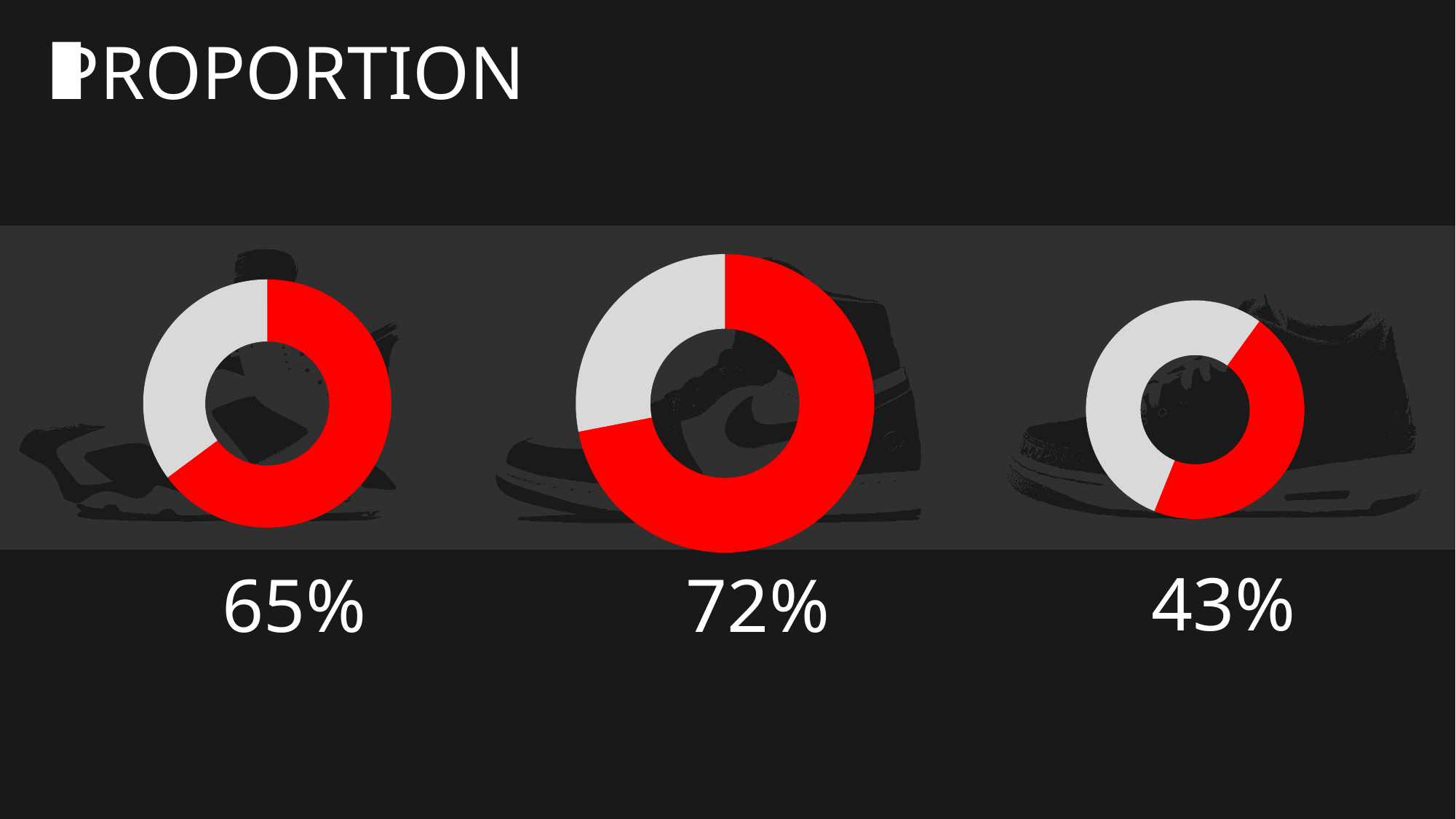
What percentage is shown below the left doughnut chart? 65% What is the title of the slide? PROPORTION What is the difference between the percentage of the middle chart and the percentage of the left chart? 7% How many doughnut charts are shown on the slide? 3 What colour is used for the filled (percentage) portion of each doughnut chart? Red Which of the three doughnut charts shows the lowest percentage? The right chart (43%) What percentage is shown below the right doughnut chart? 43% What percentage is shown below the middle doughnut chart? 72% Which is larger, the percentage of the left chart or the percentage of the right chart? The left chart (65%) What kind of chart is used to display the percentages on this slide? Doughnut chart What is the difference between the percentage of the left chart and the percentage of the right chart? 22% Which of the three doughnut charts shows the highest percentage? The middle chart (72%)